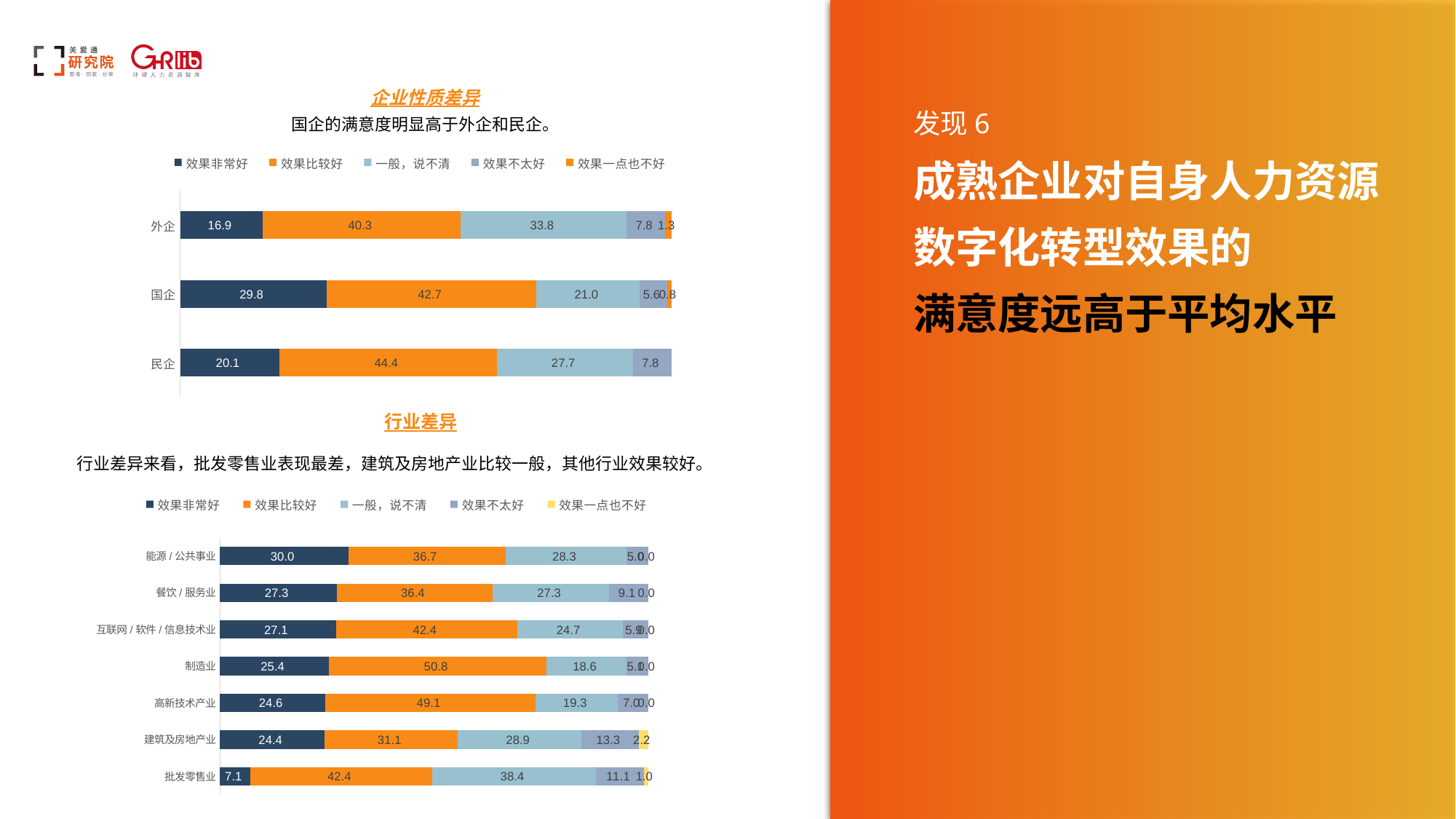
In the 行业差异 chart, which industry has the highest 效果不太好 value? 建筑及房地产业 In the 行业差异 chart, how many industries are listed? 7 In the 企业性质差异 chart, what is the difference between the 效果比较好 values for 民企 and 外企? 4.1 In the 企业性质差异 chart, how many categories are shown on the vertical axis? 3 How many series does the legend of the 行业差异 chart list? 5 In the 行业差异 chart, is the 效果比较好 value larger for 高新技术产业 or for 建筑及房地产业? 高新技术产业 In the 企业性质差异 chart, what is the 效果非常好 value for 国企? 29.8 In the 企业性质差异 chart, which category has the highest 效果非常好 value? 国企 In the 行业差异 chart, what is the 效果非常好 value for 批发零售业? 7.1 In the 行业差异 chart, which industry has the lowest 效果非常好 value? 批发零售业 In the 企业性质差异 chart, what is the 一般，说不清 value for 外企? 33.8 In the 行业差异 chart, what is the 效果比较好 value for 制造业? 50.8